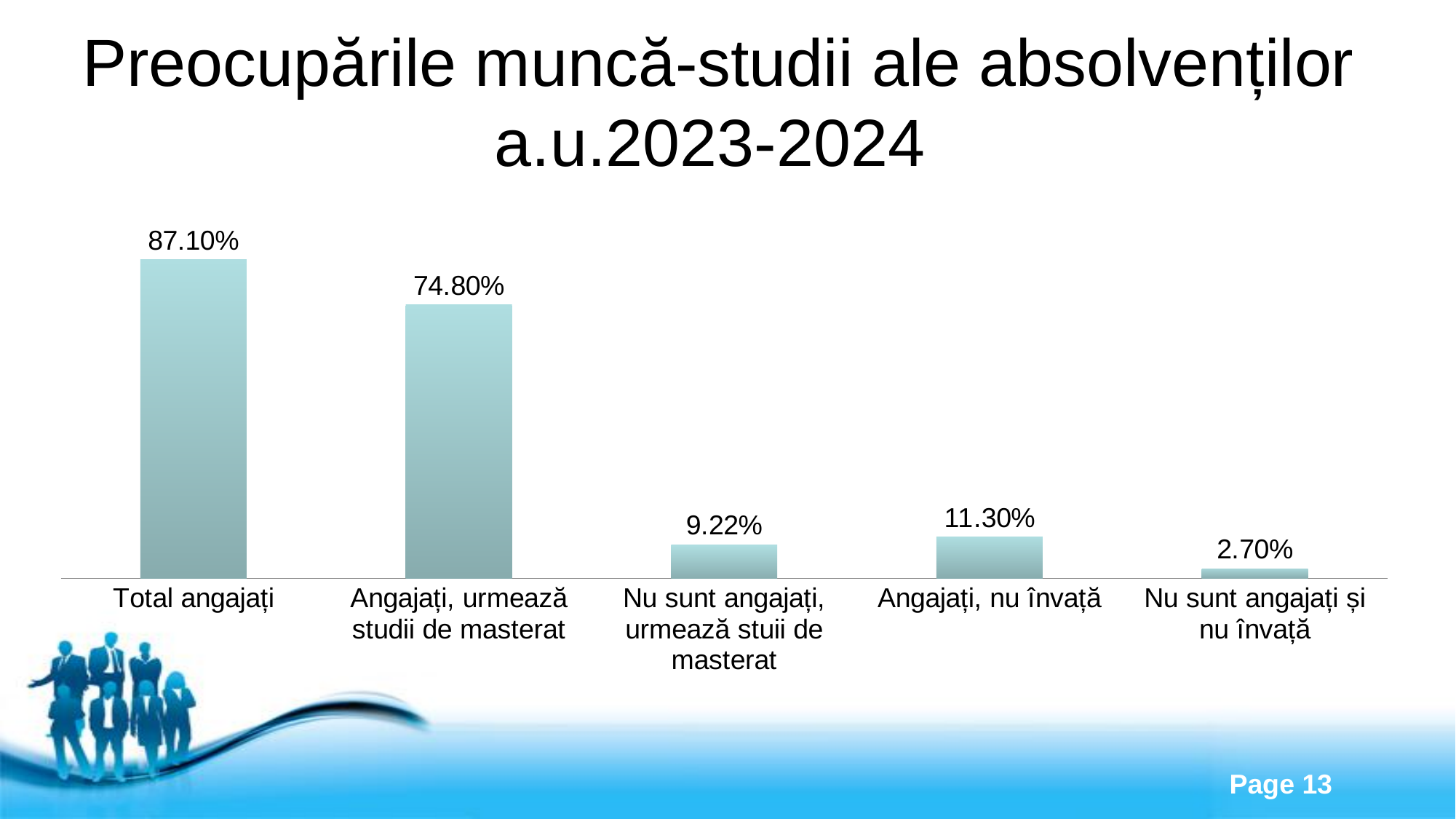
What is the value for "Angajați, nu învață"? 11.30% What is the value for "Nu sunt angajați și nu învață"? 2.70% What kind of chart is shown on the slide? Bar chart Which is larger: the value for "Angajați, nu învață" or the value for "Nu sunt angajați, urmează stuii de masterat"? Angajați, nu învață What is the value for "Nu sunt angajați, urmează stuii de masterat"? 9.22% What is the difference between the values for "Total angajați" and "Angajați, urmează studii de masterat"? 12.30% Which category has the lowest value? Nu sunt angajați și nu învață What is the value for "Angajați, urmează studii de masterat"? 74.80% What is the value for "Total angajați"? 87.10% How many categories are shown in the chart? 5 Which category has the highest value? Total angajați What is the title of the slide containing the chart? Preocupările muncă-studii ale absolvenților a.u.2023-2024